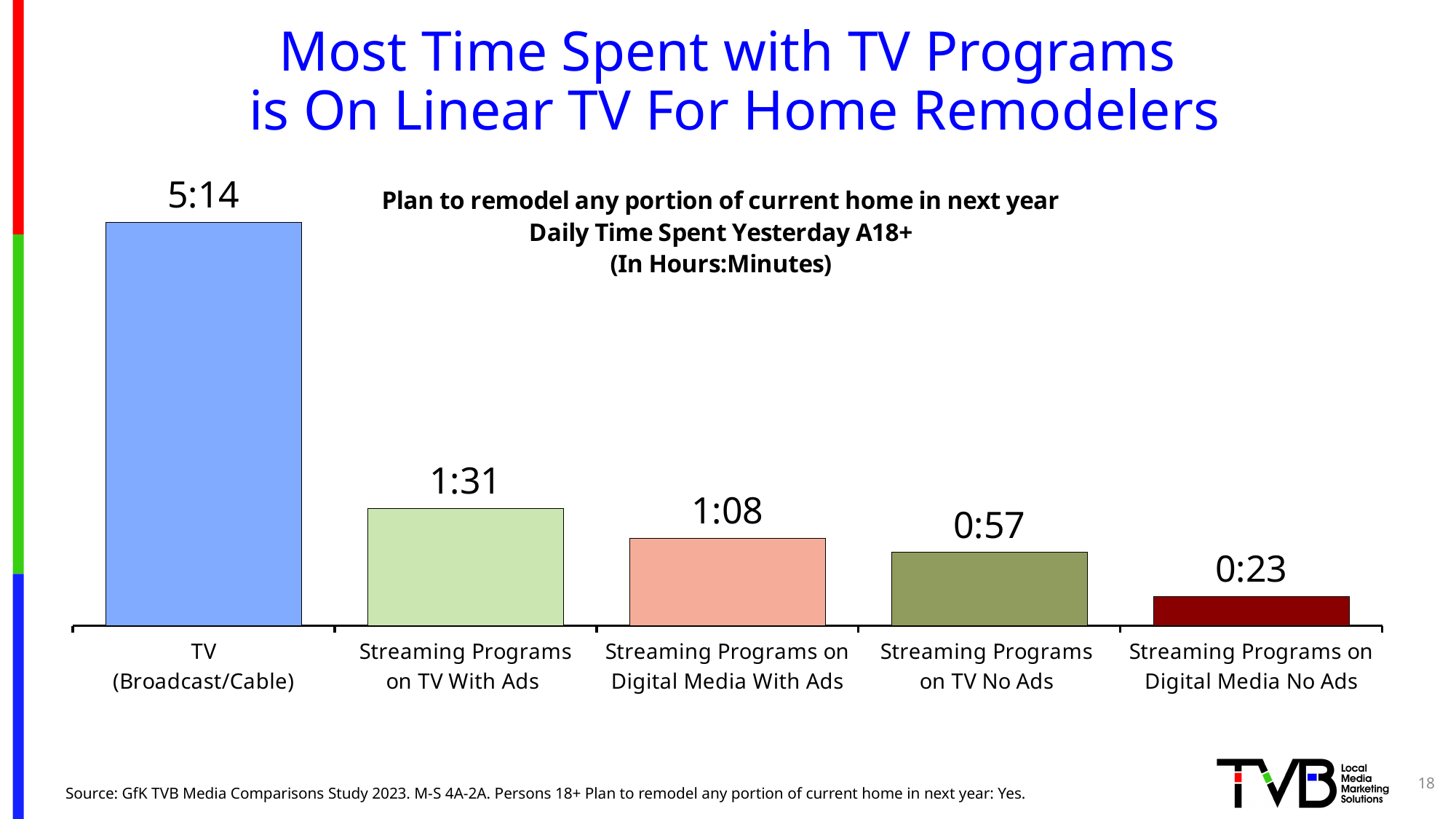
What is the daily time spent for Streaming Programs on TV With Ads? 1:31 Which is larger: Streaming Programs on Digital Media With Ads or Streaming Programs on TV No Ads? Streaming Programs on Digital Media With Ads What type of chart is shown on the slide? Bar chart What is the daily time spent for Streaming Programs on Digital Media With Ads? 1:08 Which category has the lowest daily time spent? Streaming Programs on Digital Media No Ads What is the daily time spent for Streaming Programs on Digital Media No Ads? 0:23 How much more time is spent on TV (Broadcast/Cable) than on Streaming Programs on TV With Ads? 3:43 Which category has the highest daily time spent? TV (Broadcast/Cable) What is the daily time spent for Streaming Programs on TV No Ads? 0:57 What is the daily time spent for TV (Broadcast/Cable)? 5:14 How many categories are shown in the chart? 5 What is the difference between Streaming Programs on TV No Ads and Streaming Programs on Digital Media No Ads? 0:34